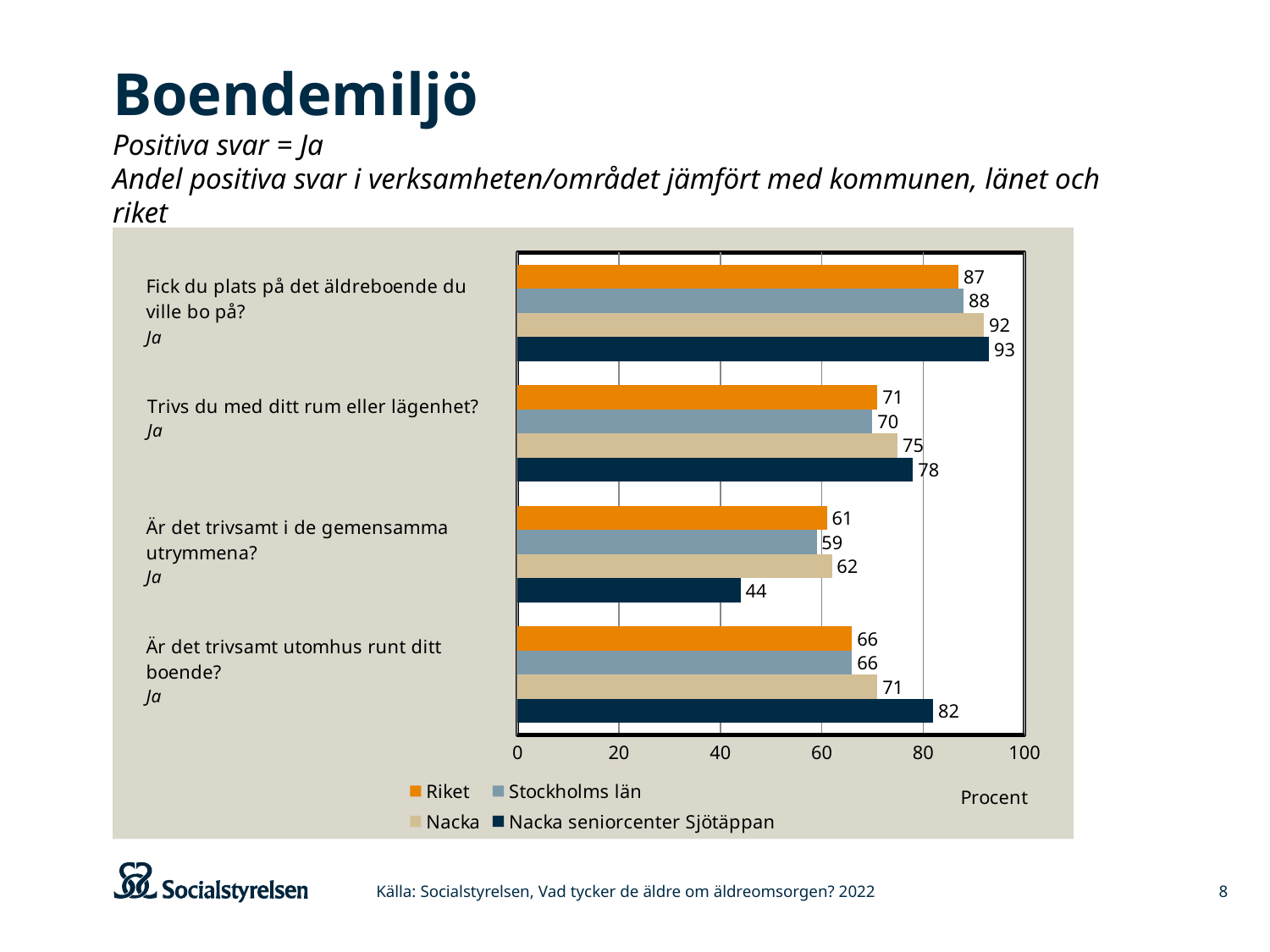
Which question has the highest value for Riket? Fick du plats på det äldreboende du ville bo på? What is the value for Riket for "Trivs du med ditt rum eller lägenhet?"? 71 Is the value for Nacka seniorcenter Sjötäppan for "Trivs du med ditt rum eller lägenhet?" greater or less than 60? greater What is the value for Stockholms län for "Är det trivsamt i de gemensamma utrymmena?"? 59 How many series does the legend list? 4 What is the value for Nacka for "Är det trivsamt utomhus runt ditt boende?"? 71 What is the difference between Nacka seniorcenter Sjötäppan and Riket for "Är det trivsamt utomhus runt ditt boende?"? 16 What kind of chart is shown on the slide? Bar chart Which is larger for "Är det trivsamt i de gemensamma utrymmena?": Nacka or Nacka seniorcenter Sjötäppan? Nacka Which question has the lowest value for Nacka seniorcenter Sjötäppan? Är det trivsamt i de gemensamma utrymmena? How many questions (categories) are shown on the chart? 4 What is the value for Nacka seniorcenter Sjötäppan for "Fick du plats på det äldreboende du ville bo på?"? 93